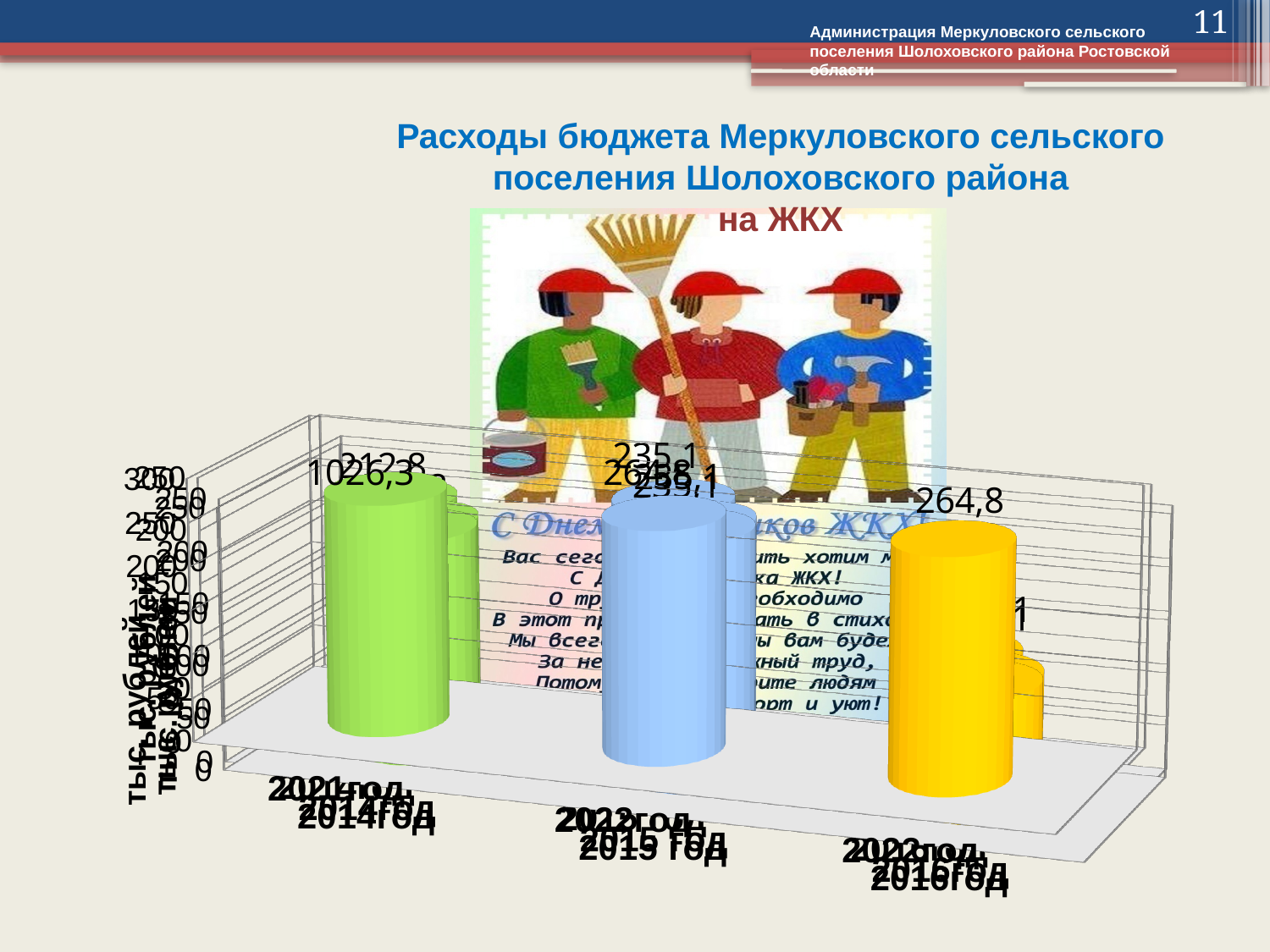
Is the value labelled on the yellow bar greater or less than 250? greater What is the title of the chart on the slide? Расходы бюджета Меркуловского сельского поселения Шолоховского района на ЖКХ What colours are the three large bars in the front of the chart, from left to right? green, blue, yellow What value is labelled on the yellow bar in the front of the chart? 264,8 What kind of chart is shown on the slide? bar chart